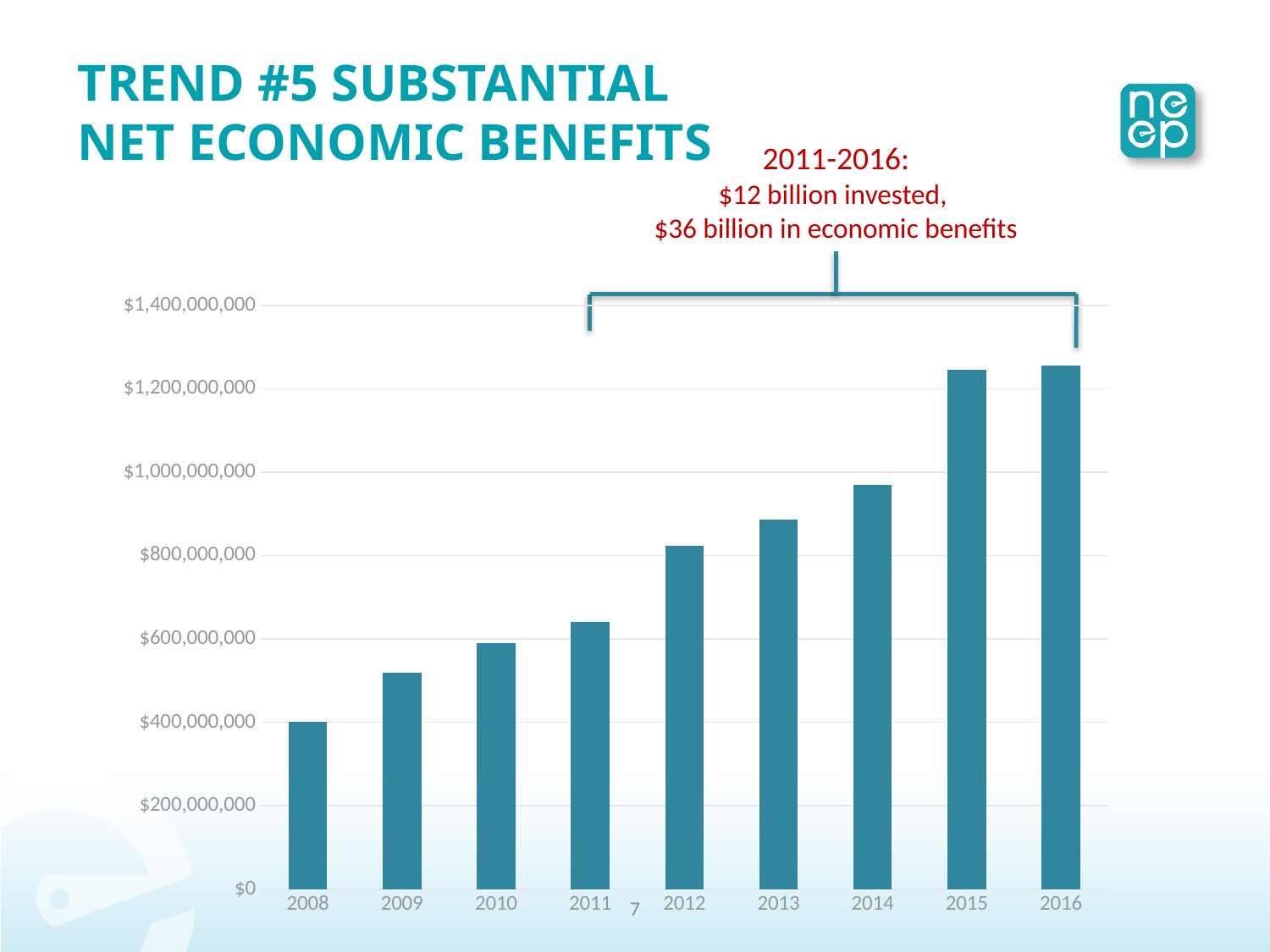
According to the annotation above the chart, how much was invested in 2011-2016? $12 billion Which year has the lowest value in the chart? 2008 Is the value for 2012 greater or less than $800,000,000? greater How many years are plotted on the x axis of the chart? 9 Is the value for 2011 greater or less than $600,000,000? greater Is the value for 2014 greater or less than $1,000,000,000? less Which year has the larger value, 2010 or 2013? 2013 According to the annotation above the chart, how much in economic benefits resulted in 2011-2016? $36 billion Do the values generally rise or fall from 2008 to 2016? rise What kind of chart is shown on the slide? bar chart